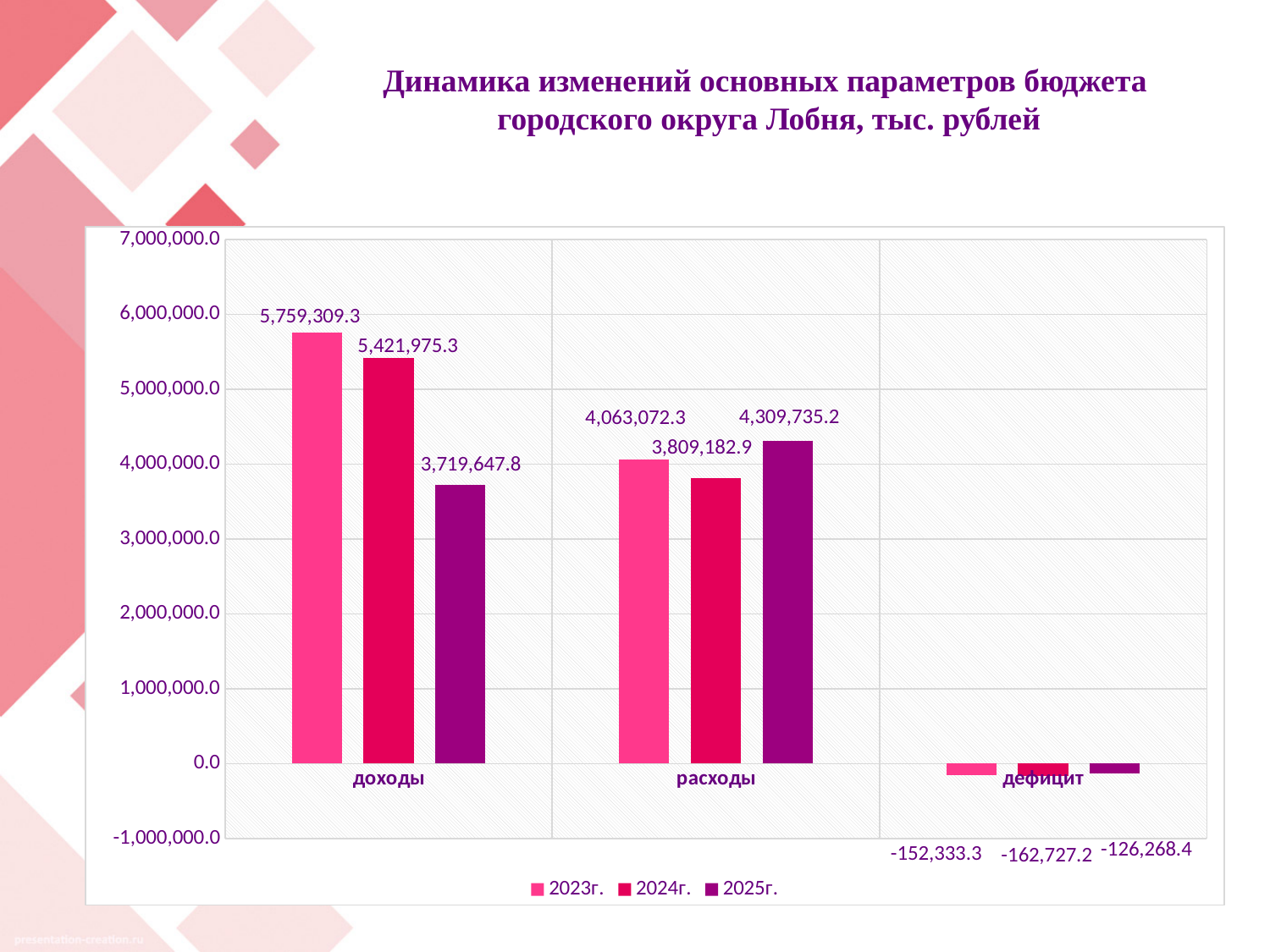
What type of chart is shown on the slide? bar chart What is the value for дефицит in 2024г.? -162,727.2 What is the value for расходы in 2025г.? 4,309,735.2 How many series does the legend list? 3 Which is larger: доходы in 2025г. or расходы in 2025г.? расходы in 2025г. Which year has the lowest value for расходы? 2024г. What is the difference between the расходы values for 2025г. and 2024г.? 500,552.3 What is the value for доходы in 2025г.? 3,719,647.8 How many categories are shown on the x axis? 3 What is the difference between the доходы values for 2023г. and 2024г.? 337,334.0 Which year has the highest value for доходы? 2023г. What is the value for доходы in 2023г.? 5,759,309.3